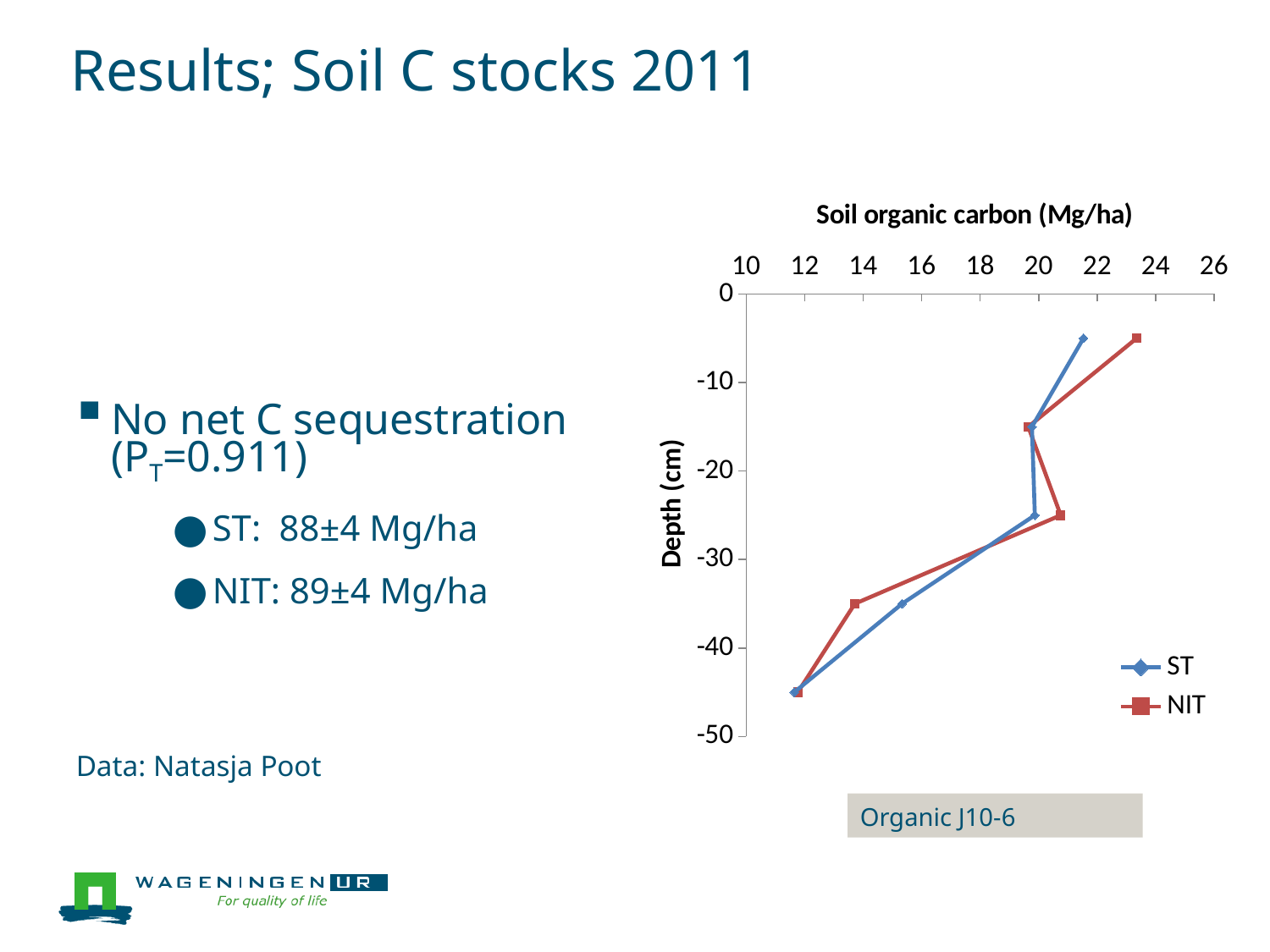
Is the soil organic carbon value for ST at a depth of -35 cm greater or less than 14? greater At a depth of -35 cm, which series has the higher soil organic carbon value, ST or NIT? ST What kind of chart is shown on the slide? line chart Is the soil organic carbon value for NIT at a depth of -5 cm greater or less than 22? greater What is the title of the horizontal axis of the chart? Soil organic carbon (Mg/ha) How many depth points are plotted for the NIT series? 5 At which depth does the NIT series reach its highest soil organic carbon value? -5 cm Which two series are listed in the chart legend? ST and NIT At a depth of -5 cm, which series has the higher soil organic carbon value, ST or NIT? NIT How many series does the chart legend list? 2